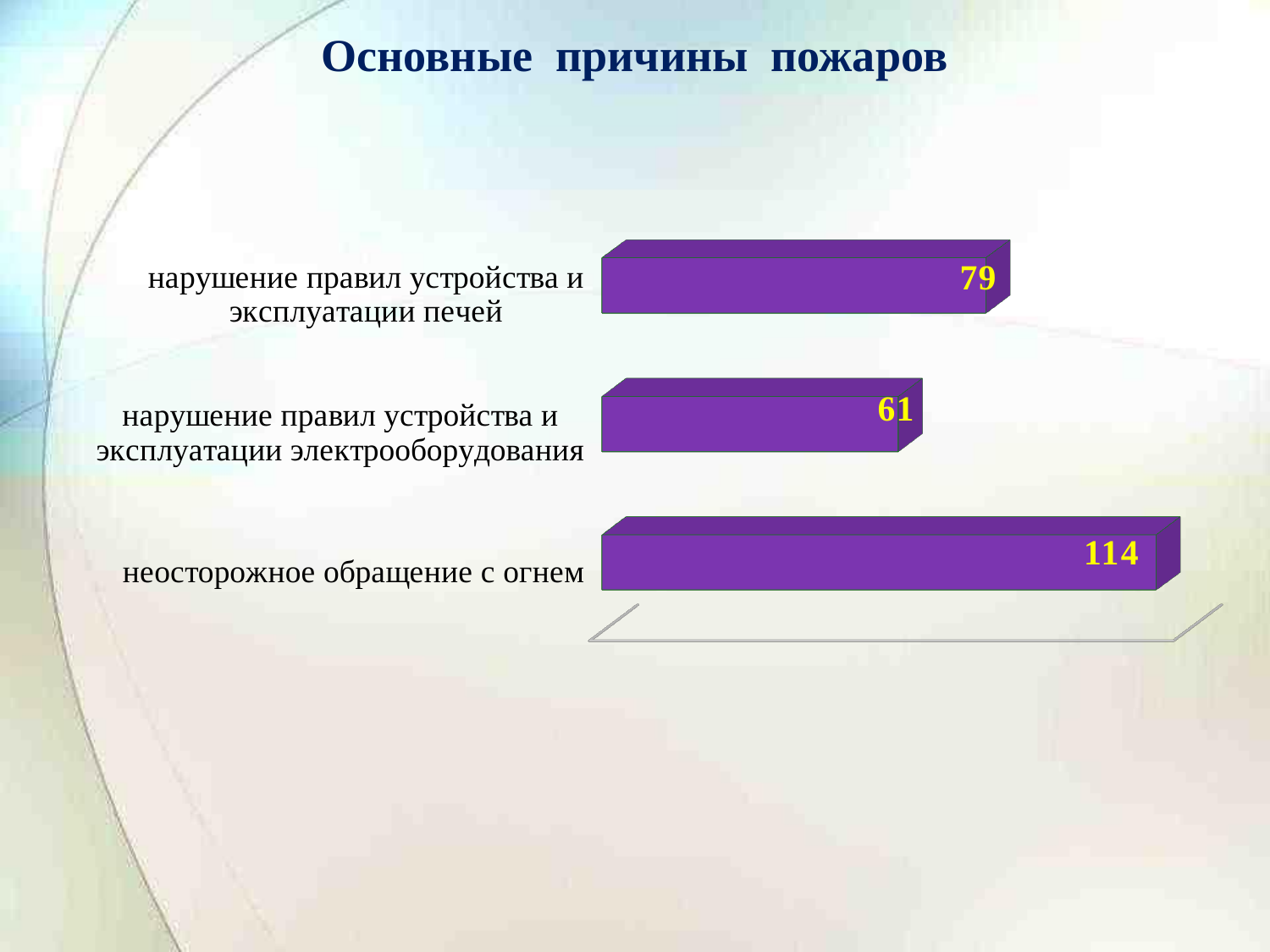
What is the value for "нарушение правил устройства и эксплуатации печей"? 79 What is the difference between the values for "неосторожное обращение с огнем" and "нарушение правил устройства и эксплуатации печей"? 35 What is the title of the slide? Основные причины пожаров Which category has the highest value? неосторожное обращение с огнем What is the value for "неосторожное обращение с огнем"? 114 What is the difference between the values for "нарушение правил устройства и эксплуатации печей" and "нарушение правил устройства и эксплуатации электрооборудования"? 18 What kind of chart is shown on the slide? bar chart What colour are the bars in the chart? purple What is the value for "нарушение правил устройства и эксплуатации электрооборудования"? 61 Which category has the lowest value? нарушение правил устройства и эксплуатации электрооборудования How many categories are shown in the chart? 3 Which is larger: the value for "нарушение правил устройства и эксплуатации печей" or for "нарушение правил устройства и эксплуатации электрооборудования"? нарушение правил устройства и эксплуатации печей